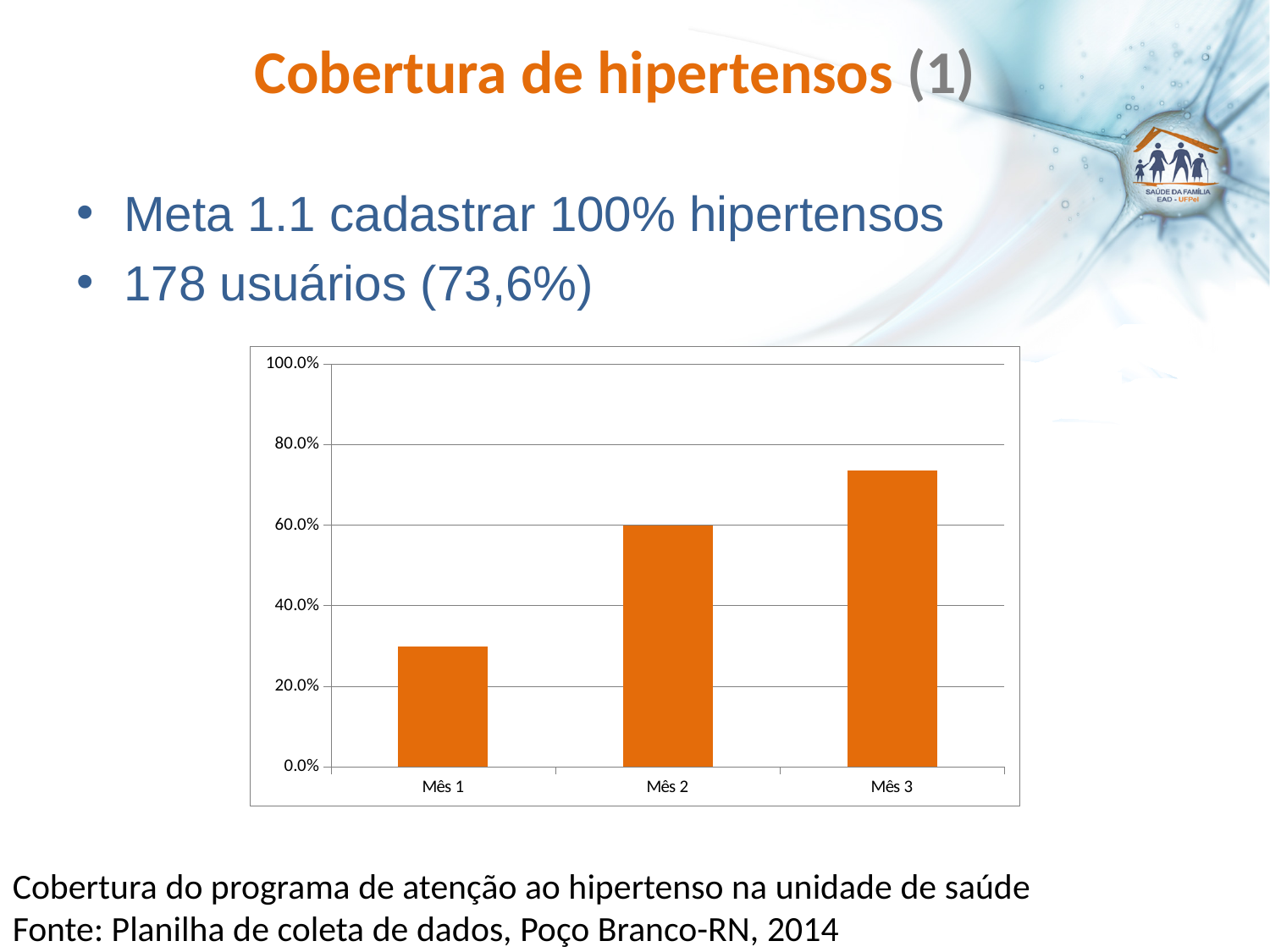
What is the highest value shown on the chart's y axis? 100.0% Is the value for Mês 3 greater or less than 80.0%? less Is the value for Mês 1 greater or less than 40.0%? less Is the value for Mês 2 greater or less than 40.0%? greater Do the values rise or fall from Mês 1 to Mês 3? rise What kind of chart is shown on the slide? bar chart Which is larger, the value for Mês 2 or the value for Mês 1? Mês 2 How many categories (months) are plotted on the x axis of the chart? 3 Which month has the highest bar in the chart? Mês 3 Which month has the lowest bar in the chart? Mês 1